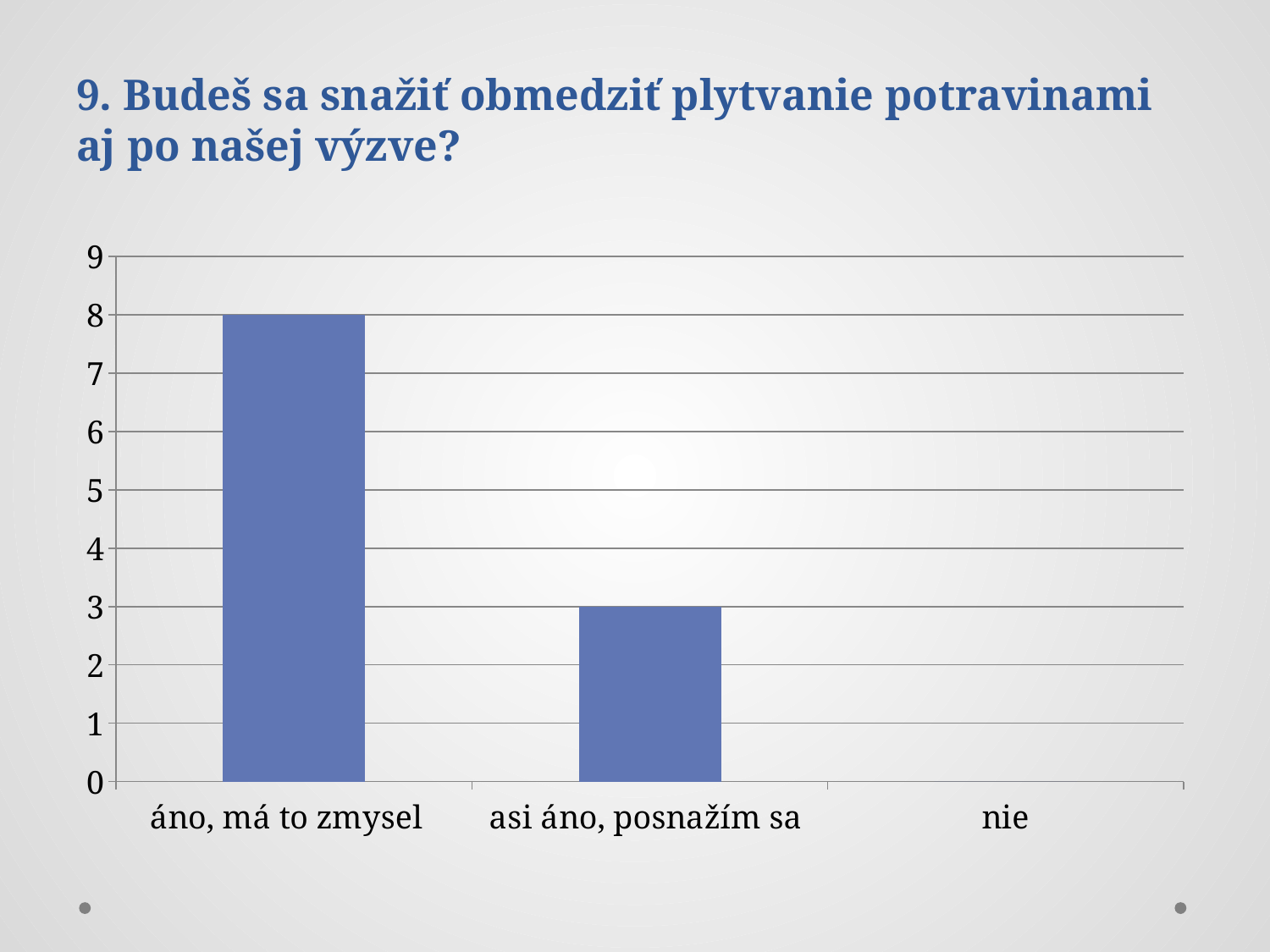
Do the values rise or fall from left to right along the x axis? fall What is the difference between the values for "áno, má to zmysel" and "asi áno, posnažím sa"? 5 How many categories are shown on the x axis of the chart? 3 Which category has the lowest value? nie Which is larger, the value for "asi áno, posnažím sa" or the value for "nie"? asi áno, posnažím sa What is the value for "áno, má to zmysel"? 8 What is the value for "nie"? 0 Which category has the highest value? áno, má to zmysel What is the highest value shown on the vertical axis? 9 What is the value for "asi áno, posnažím sa"? 3 What kind of chart is shown on the slide? bar chart Is the value for "áno, má to zmysel" greater or less than 5? greater